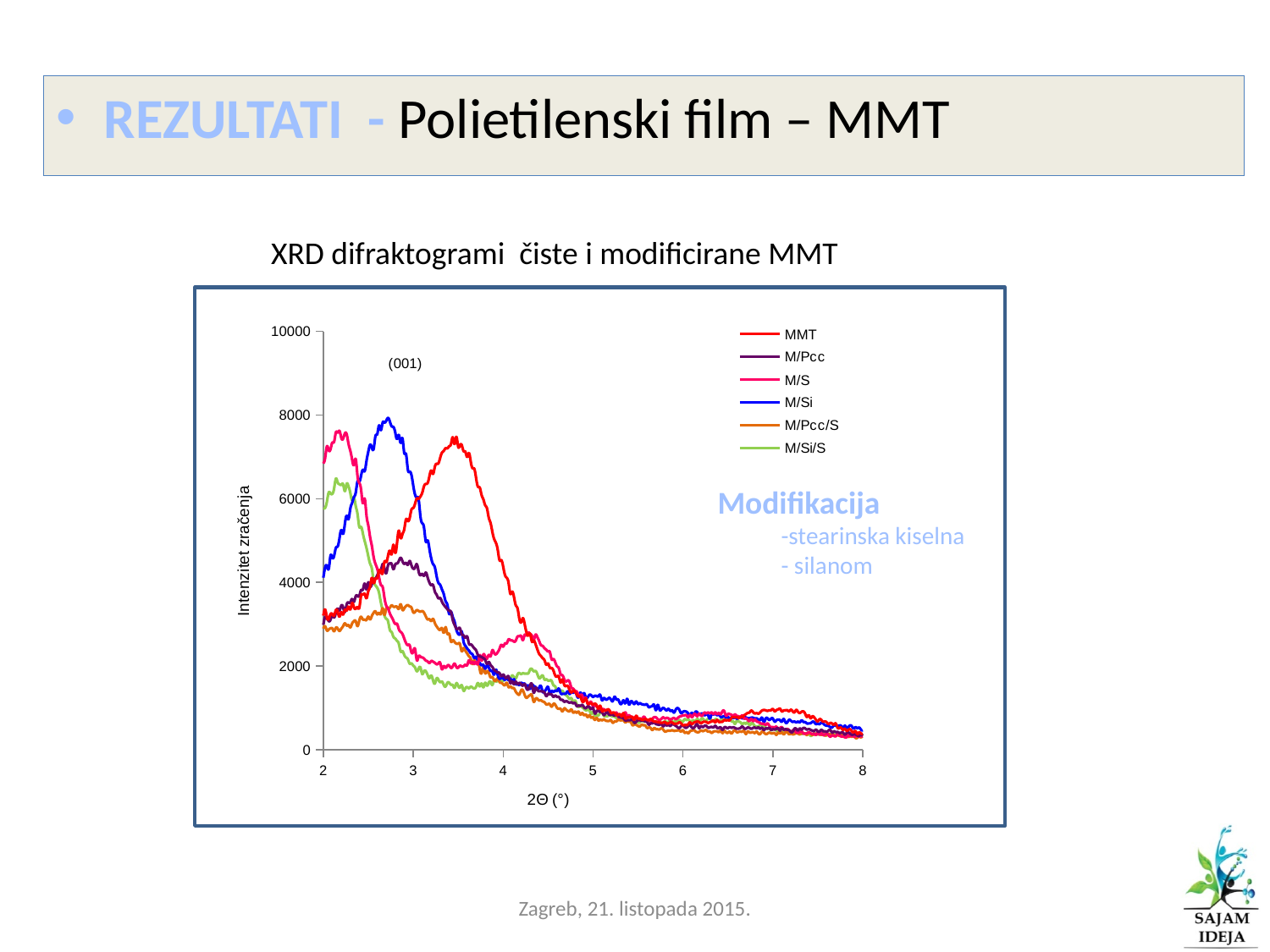
Is the peak value of the M/Pcc/S series greater or less than 4000? less What kind of chart is shown on the slide? line chart Does the MMT series rise or fall between 2Θ = 4° and 2Θ = 8°? fall What is the label of the x axis? 2Θ (°) Is the value of the MMT series at 2Θ = 8° greater or less than 1000? less What colour is the MMT series drawn in? red Which series has a higher peak, M/Si or M/Pcc? M/Si Which series has the lowest peak intensity? M/Pcc/S How many series does the legend list? 6 Is the peak value of the MMT series greater or less than 6000? greater Which series reaches the highest peak intensity? M/Si